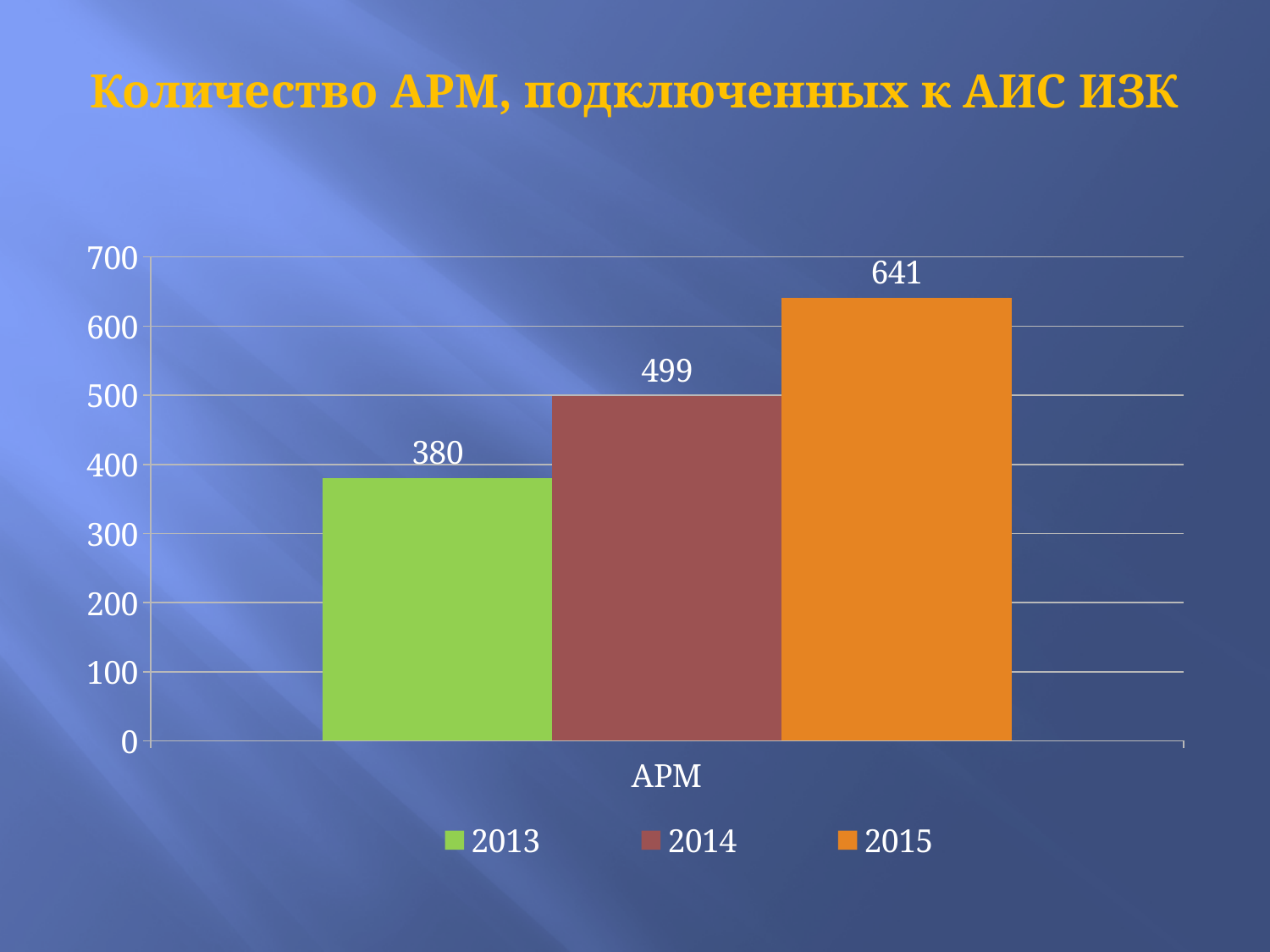
Which year has the highest value? 2015 What is the title of the chart? Количество АРМ, подключенных к АИС ИЗК Which is larger, the value for 2014 or the value for 2015? 2015 Which year has the lowest value? 2013 What kind of chart is shown on the slide? bar chart What is the value for 2015? 641 How many series does the legend list? 3 What is the difference between the values for 2014 and 2013? 119 What is the value for 2013? 380 What is the value for 2014? 499 What is the difference between the values for 2015 and 2013? 261 Is the value for 2015 greater or less than 600? greater